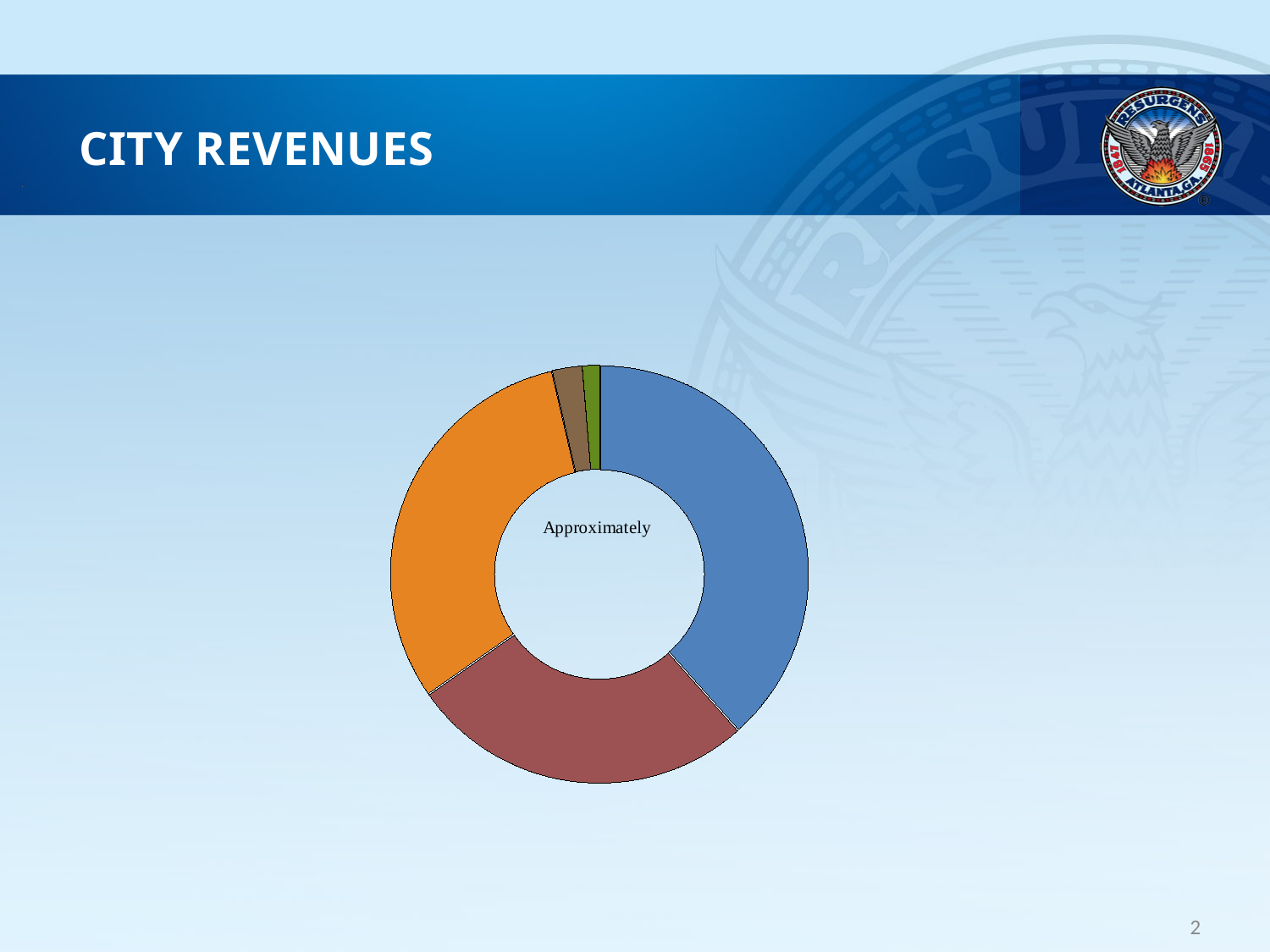
Which is larger in the doughnut chart, the orange slice or the brown slice? orange What kind of chart is shown on the slide? doughnut chart Which is larger in the doughnut chart, the blue slice or the green slice? blue What word is printed in the centre of the doughnut chart? Approximately Which colour slice is the smallest in the doughnut chart? green What is the title of the slide containing the chart? CITY REVENUES Which colour slice is the largest in the doughnut chart? blue How many slices does the doughnut chart have? 5